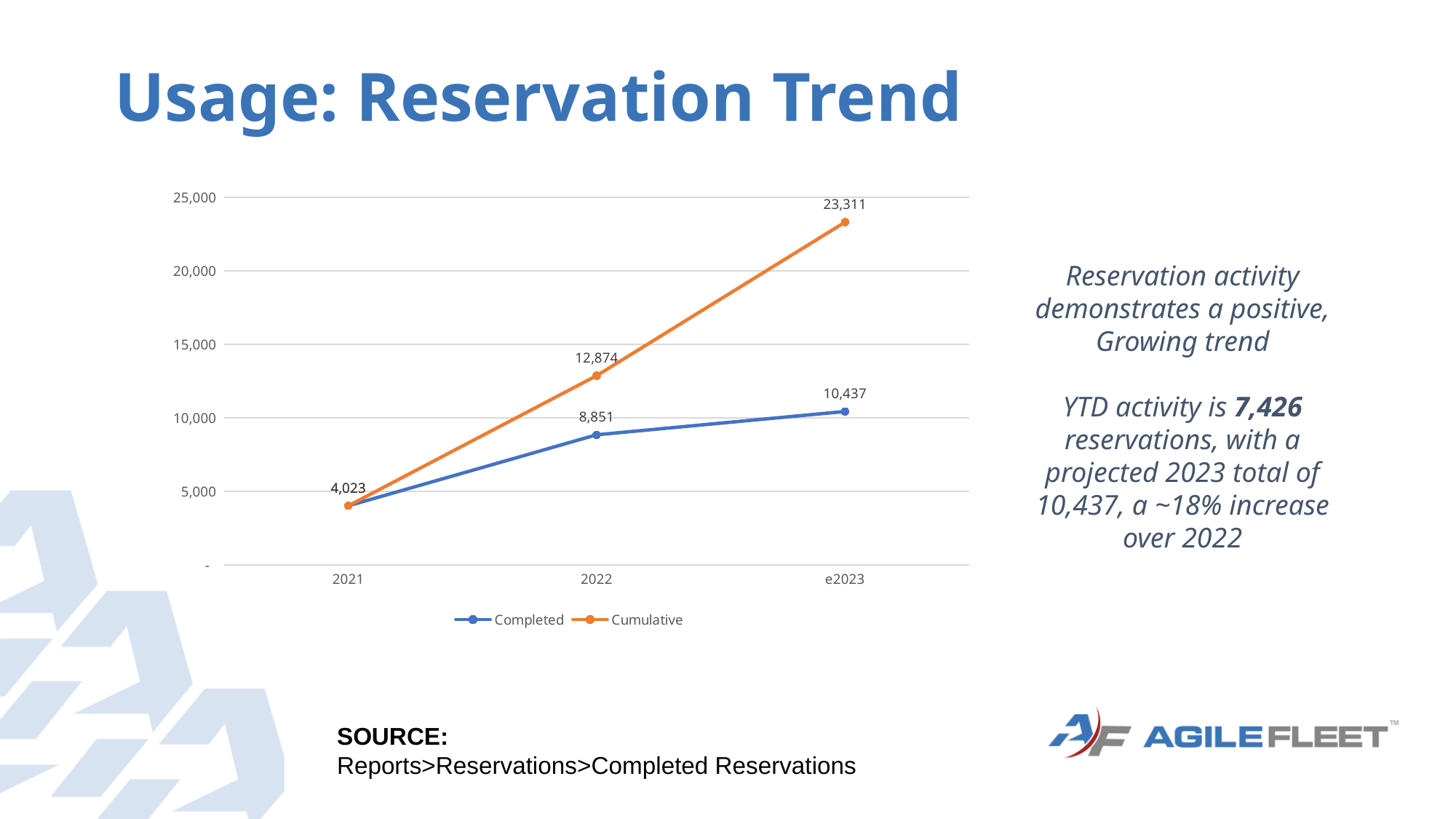
What is the Cumulative value for e2023? 23,311 Which year has the lowest Completed value? 2021 Do the Completed values rise or fall from 2021 to e2023? Rise What is the difference between the Cumulative and Completed values for e2023? 12,874 What is the Cumulative value for 2022? 12,874 How many series does the legend list? 2 Which year has the highest Cumulative value? e2023 What are the names of the two series in the legend? Completed and Cumulative What is the Completed value for e2023? 10,437 How many points are plotted along the x axis for each series? 3 What is the Completed value for 2022? 8,851 What type of chart is shown on the slide? Line chart